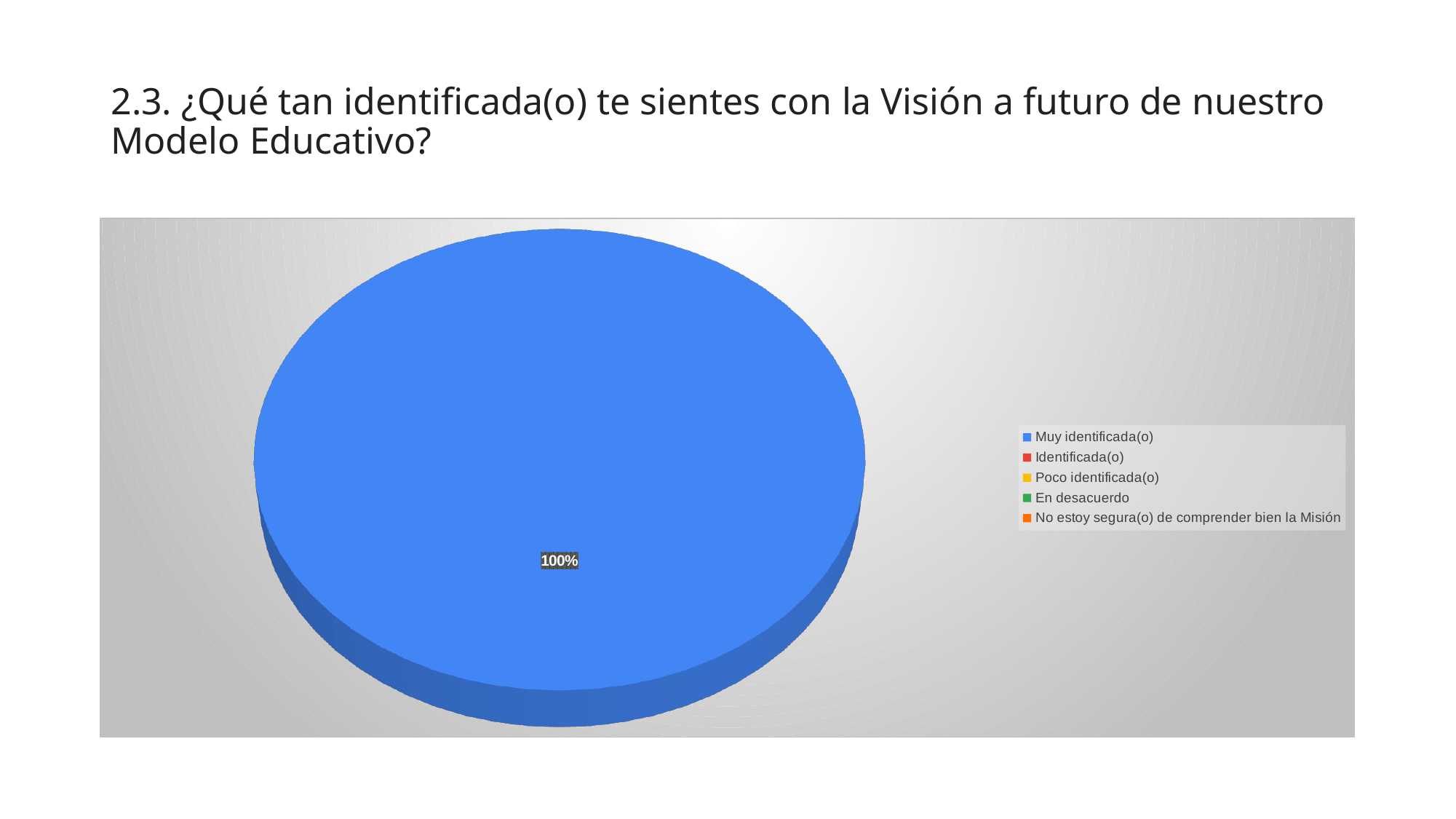
What kind of chart is shown on the slide? pie chart Which category has the largest share of the pie? Muy identificada(o) What share of the pie does "Muy identificada(o)" take? 100% Which legend entry is shown in blue? Muy identificada(o) What is the last entry listed in the legend? No estoy segura(o) de comprender bien la Misión How many categories does the legend list? 5 Is the share for "Muy identificada(o)" greater or less than 50%? greater What is the data label printed on the pie slice? 100% Which is larger, the share for "Muy identificada(o)" or the share for "Identificada(o)"? Muy identificada(o)